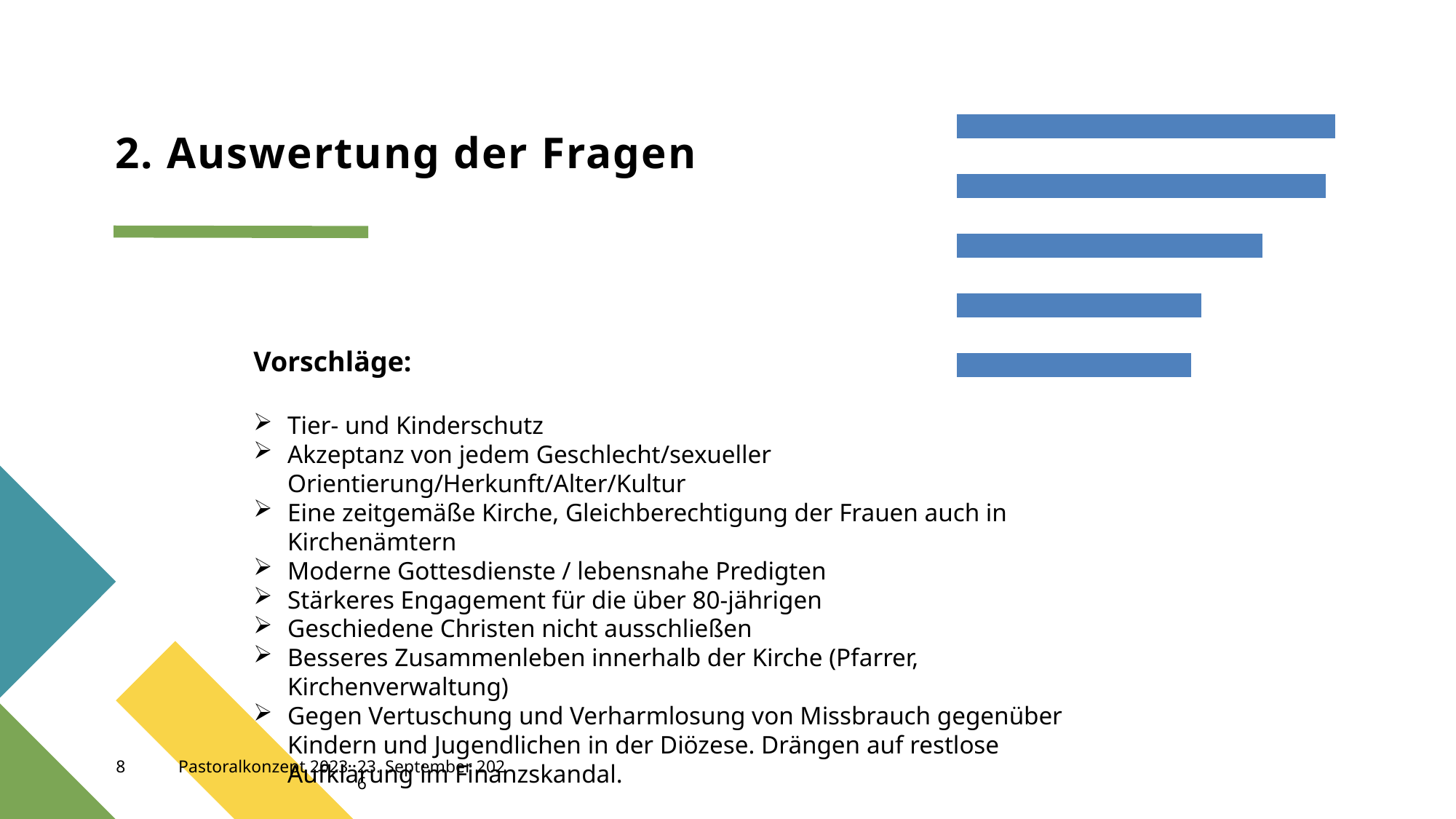
What kind of chart is shown on the right side of the slide? bar chart What colour are the bars in the chart? blue Are the bars in the chart oriented horizontally or vertically? horizontally Do the bar lengths increase or decrease from the top bar to the bottom bar? decrease Which bar in the chart is the shortest? the bottom bar Is the third bar from the top longer or shorter than the fourth bar from the top? longer Which bar in the chart is the longest? the top bar Is the top bar of the chart longer or shorter than the bottom bar? longer How many bars does the chart on the right side of the slide contain? 5